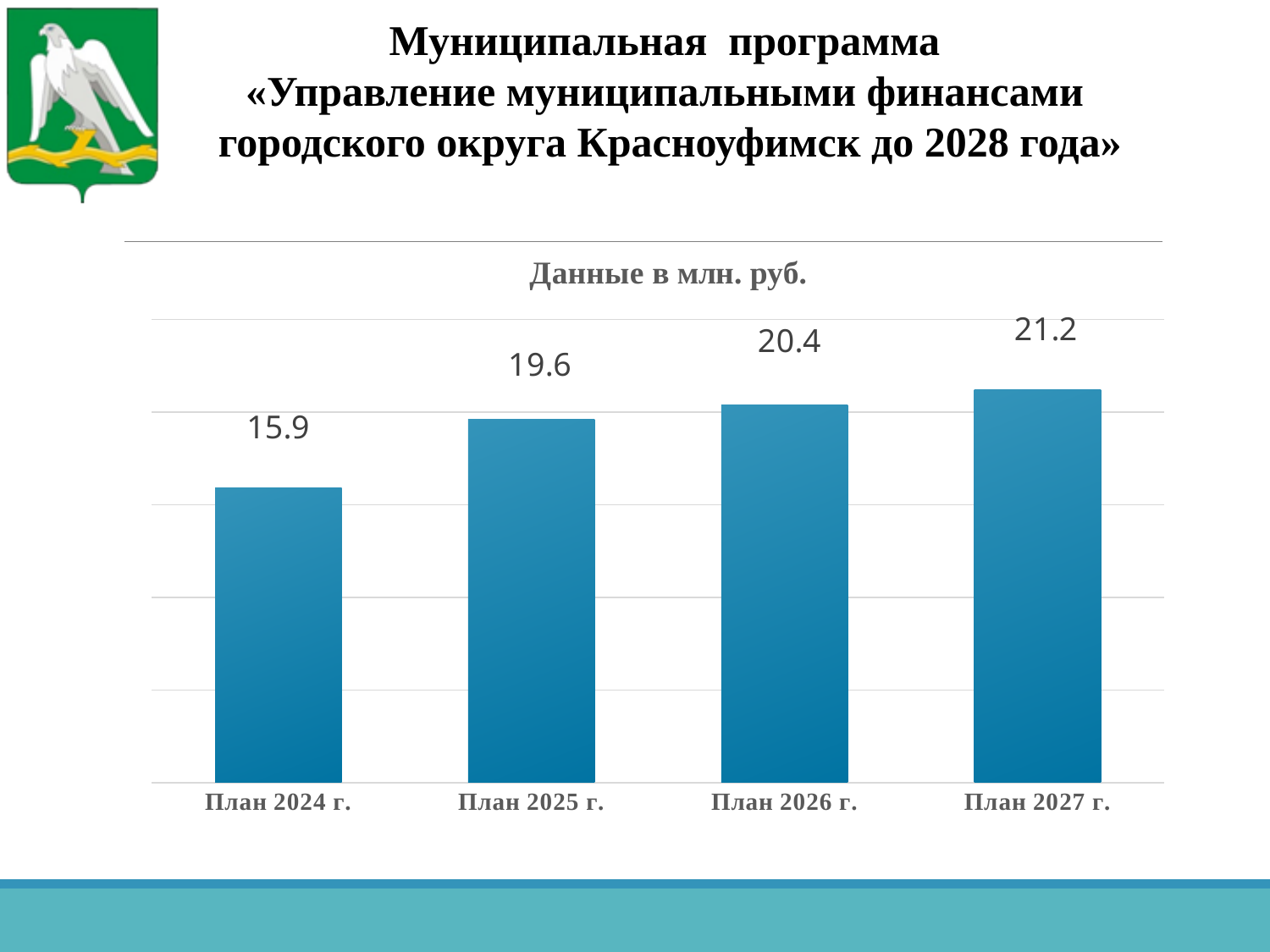
What is the difference between the values for План 2027 г. and План 2024 г.? 5.3 What is the difference between the values for План 2025 г. and План 2024 г.? 3.7 Which category has the highest value? План 2027 г. Which is larger, the value for План 2025 г. or the value for План 2026 г.? План 2026 г. How many categories are shown on the chart? 4 What is the value for План 2027 г.? 21.2 Which category has the lowest value? План 2024 г. What is the value for План 2024 г.? 15.9 Do the values rise or fall from План 2024 г. to План 2027 г.? Rise What is the value for План 2026 г.? 20.4 What kind of chart is shown on the slide? Bar chart What is the value for План 2025 г.? 19.6